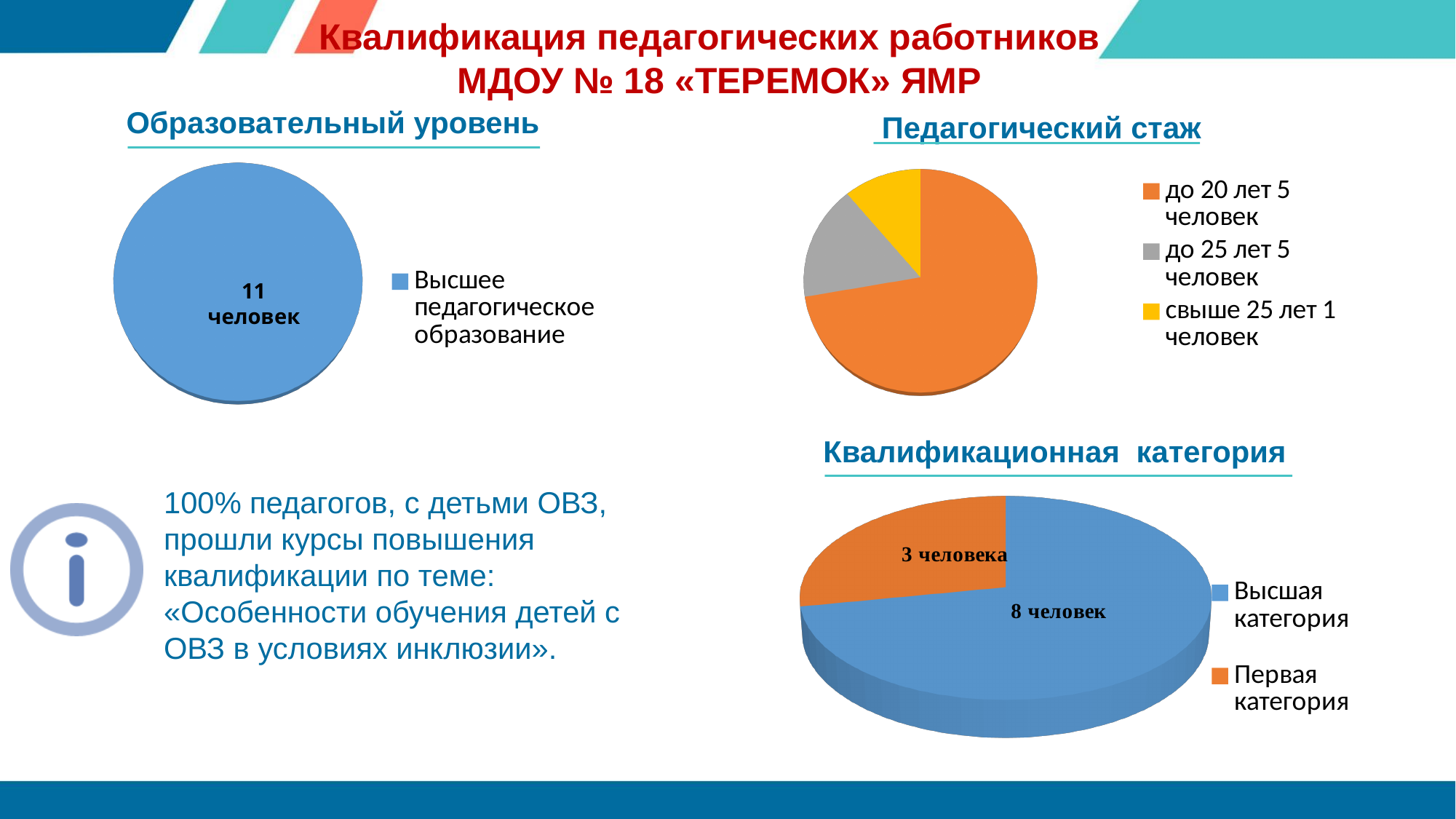
What kind of chart is the one titled «Педагогический стаж»? Pie chart On the chart titled «Образовательный уровень», what is the legend entry? Высшее педагогическое образование On the chart titled «Квалификационная категория», how many people have «Первая категория»? 3 человека On the chart titled «Педагогический стаж», how many people are in the category «свыше 25 лет»? 1 человек On the chart titled «Образовательный уровень», how many slices does the pie have? 1 On the chart titled «Образовательный уровень», how many people are shown in the pie? 11 человек On the chart titled «Педагогический стаж», how many categories does the legend list? 3 On the chart titled «Квалификационная категория», how many more people have «Высшая категория» than «Первая категория»? 5 On the chart titled «Педагогический стаж», which category has the fewest people? свыше 25 лет On the chart titled «Педагогический стаж», what colour is the slice for «до 25 лет»? Grey On the chart titled «Квалификационная категория», which category has more people? Высшая категория On the chart titled «Квалификационная категория», how many people have «Высшая категория»? 8 человек